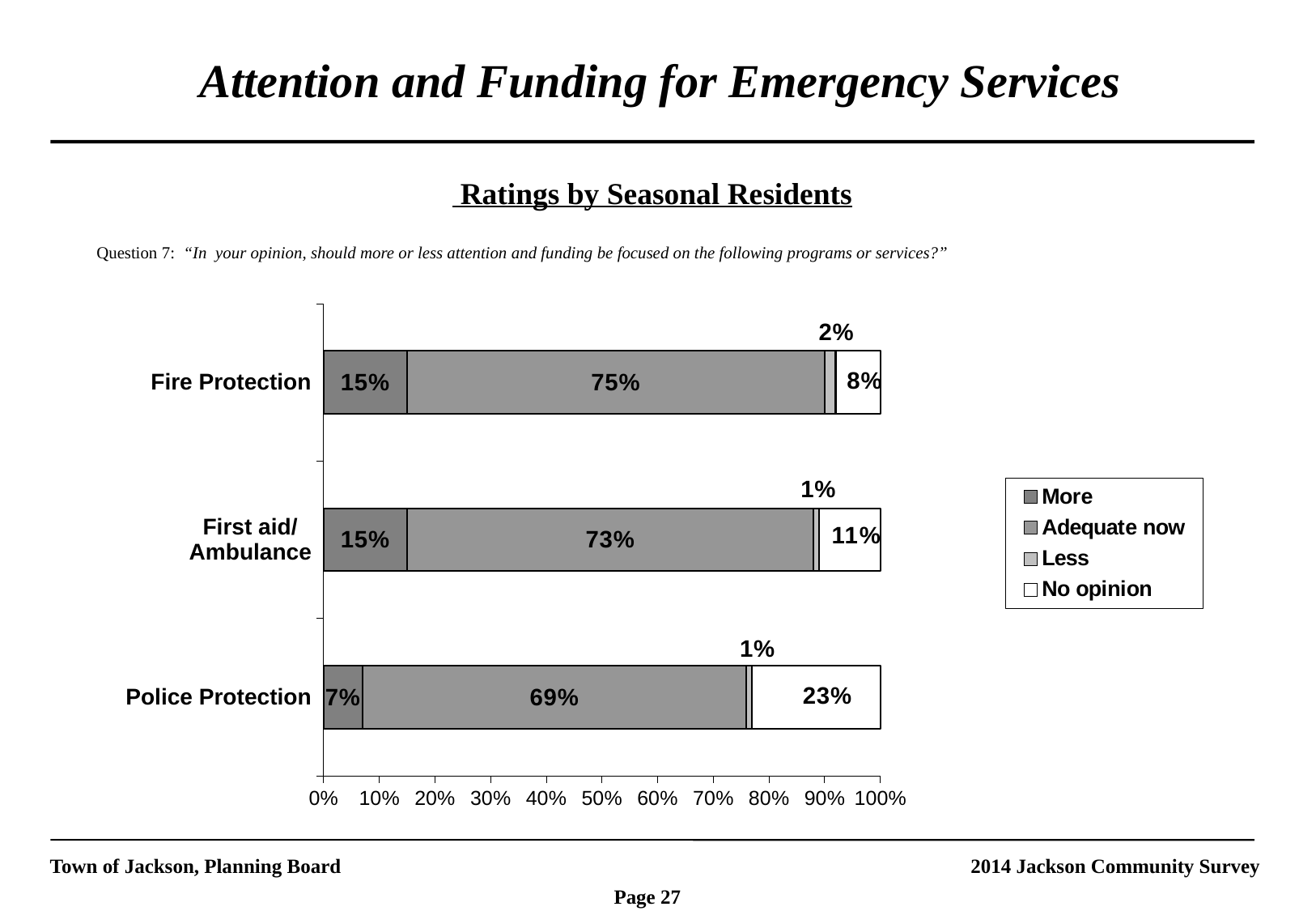
Which is larger, the 'No opinion' value for First aid/Ambulance or for Fire Protection? First aid/Ambulance Which category has the lowest 'More' value? Police Protection What is the 'More' value for First aid/Ambulance? 15% What kind of chart is shown on the slide? Stacked bar chart What is the 'Adequate now' value for Fire Protection? 75% What is the difference between the 'Adequate now' values for Fire Protection and Police Protection? 6% Which category has the highest 'No opinion' value? Police Protection What is the 'Less' value for Fire Protection? 2% How many series does the legend list? 4 What is the total of the stacked bar for Police Protection? 100% How many categories are plotted on the chart? 3 What is the 'No opinion' value for Police Protection? 23%